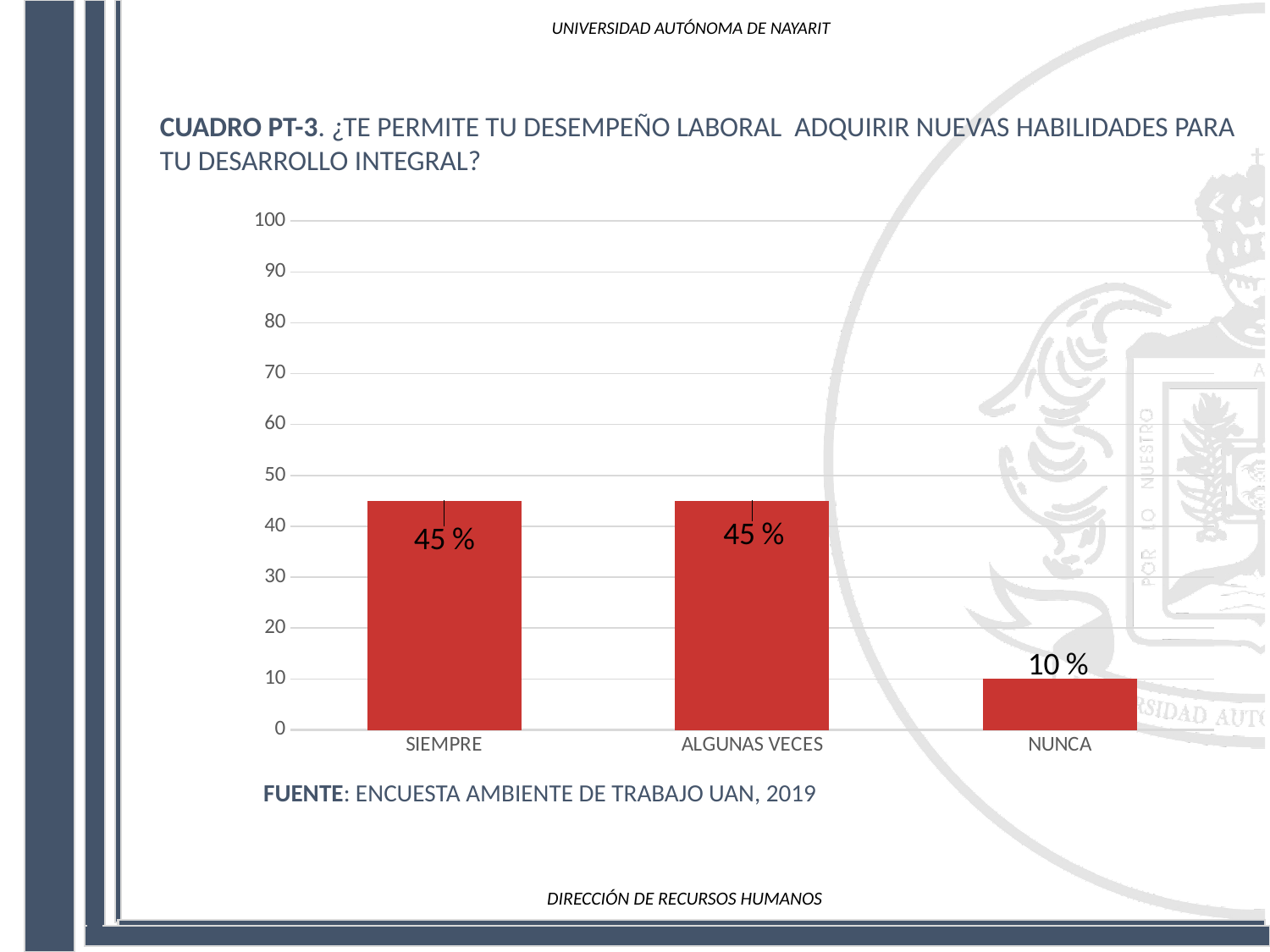
Which category has the lowest value? NUNCA What kind of chart is shown on the slide? bar chart Is the value for SIEMPRE greater or less than 40? greater What is the value for ALGUNAS VECES? 45 % Is the value for NUNCA greater or less than 20? less Which is larger, the value for ALGUNAS VECES or the value for NUNCA? ALGUNAS VECES What is the difference between the values for SIEMPRE and NUNCA? 35 % What is the maximum value shown on the y axis? 100 How many categories are shown on the x axis? 3 What is the value for NUNCA? 10 % What is the value for SIEMPRE? 45 % What source is cited below the chart? ENCUESTA AMBIENTE DE TRABAJO UAN, 2019